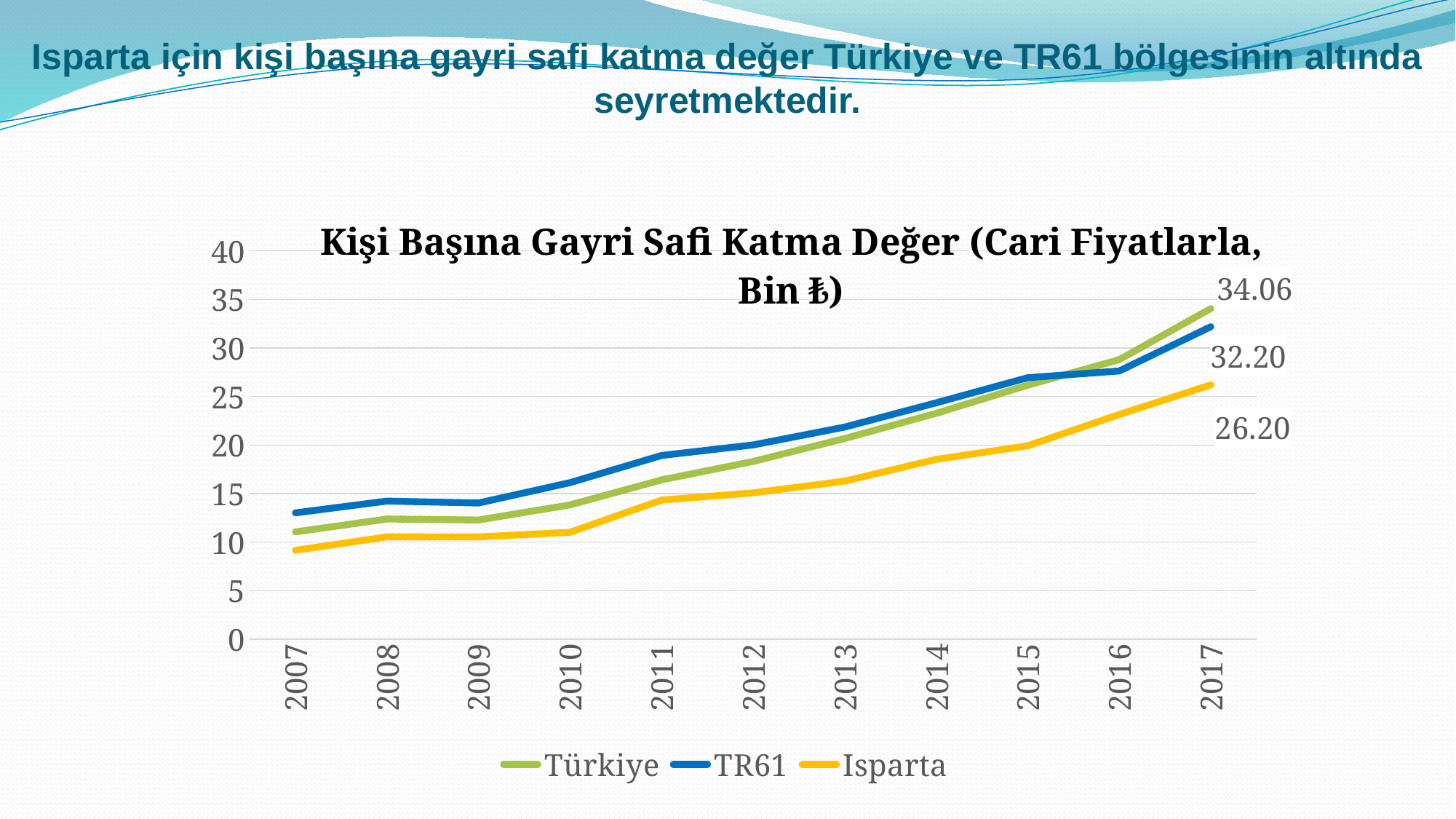
How many years are shown on the x axis? 11 What is the difference between the TR61 and Isparta values in 2017? 6.00 What is the difference between the Türkiye and Isparta values in 2017? 7.86 How many series does the legend list? 3 What is the value for TR61 in 2017? 32.20 Is the value for Isparta in 2007 greater or less than 10? less Which series has the lowest value in 2017? Isparta What is the value for Türkiye in 2017? 34.06 Which series has the highest value in 2017? Türkiye What is the value for Isparta in 2017? 26.20 In 2017, which is larger: the value for Türkiye or the value for TR61? Türkiye Is the value for TR61 in 2011 greater or less than 15? greater